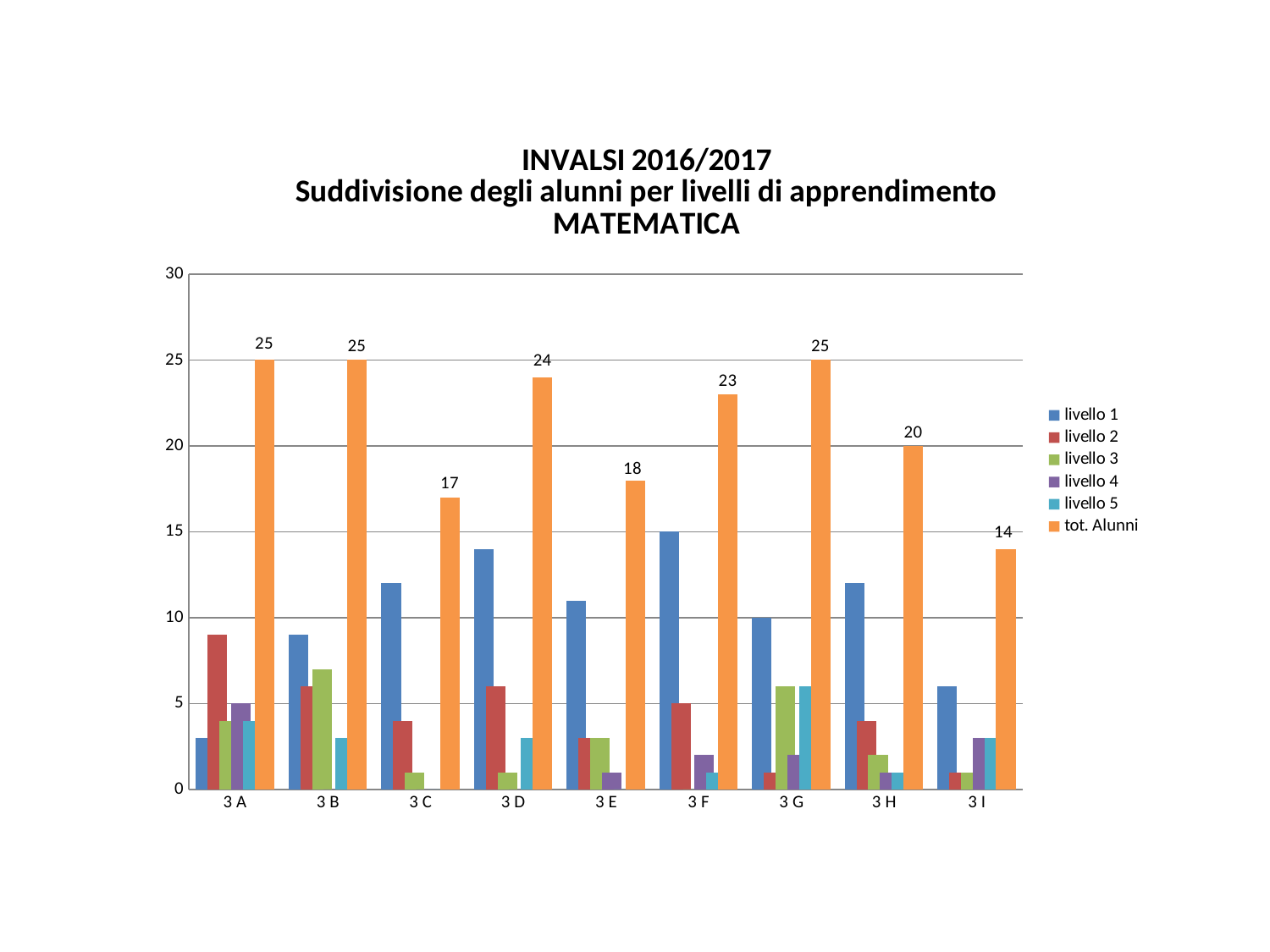
How many classes are shown on the x axis? 9 What is the difference between the tot. Alunni values for 3 F and 3 E? 5 How many series does the legend list? 6 What is the value of tot. Alunni for class 3 D? 24 What is the value of tot. Alunni for class 3 I? 14 Is the livello 1 value for 3 F greater or less than 10? greater What is the value of tot. Alunni for class 3 H? 20 What kind of chart is shown on the slide? bar chart Is the livello 2 value for 3 A greater or less than 5? greater Which class has the lowest tot. Alunni value? 3 I Which class has a larger tot. Alunni value, 3 C or 3 H? 3 H What is the difference between the tot. Alunni values for 3 D and 3 I? 10